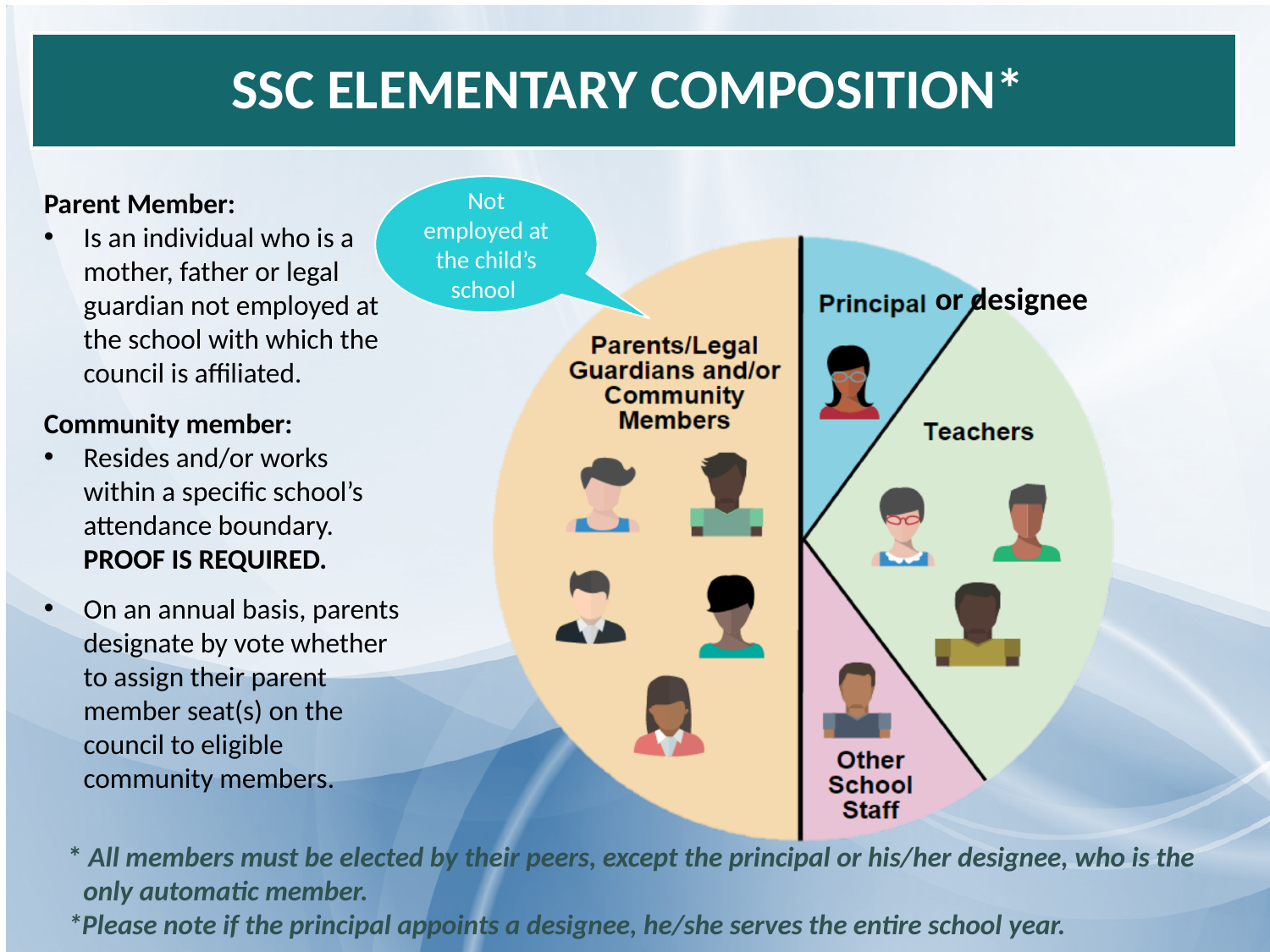
How many person icons are shown in the Teachers slice? 3 What kind of chart is shown on the slide? Pie chart What colour is the Teachers slice of the pie chart? Green Which slice is larger, Teachers or Other School Staff? Teachers Which slice is larger, Parents/Legal Guardians and/or Community Members or Teachers? Parents/Legal Guardians and/or Community Members How many person icons are shown in the Other School Staff slice? 1 Which slice of the pie chart is the largest? Parents/Legal Guardians and/or Community Members What is the title of the slide containing the pie chart? SSC ELEMENTARY COMPOSITION* How many slices does the pie chart have? 4 Which slice is larger, Teachers or Principal or designee? Teachers